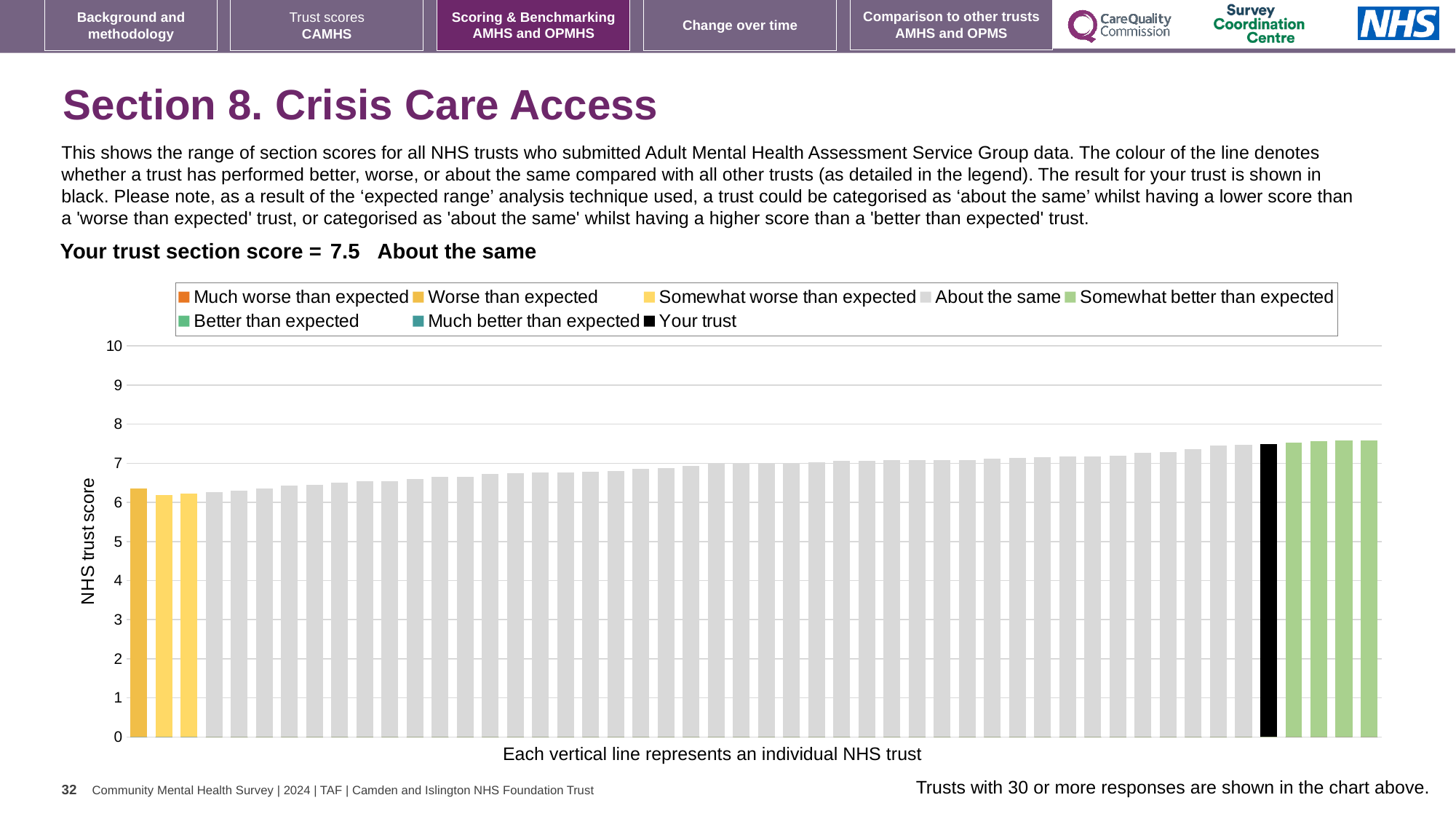
Do the bar values generally rise or fall from left to right across the chart? rise Which category is your trust's section score placed in? About the same Is the value for your trust greater or less than 8? less What colour is the bar representing your trust? black Is the value of the rightmost bar greater or less than 8? less Is the value for your trust greater or less than 7? greater What is the section score for your trust shown on the slide? 7.5 How many entries does the chart legend list? 8 Which is larger, the score for your trust or the score of the leftmost bar? your trust What kind of chart is shown on the slide? bar chart What is the label on the vertical axis of the chart? NHS trust score